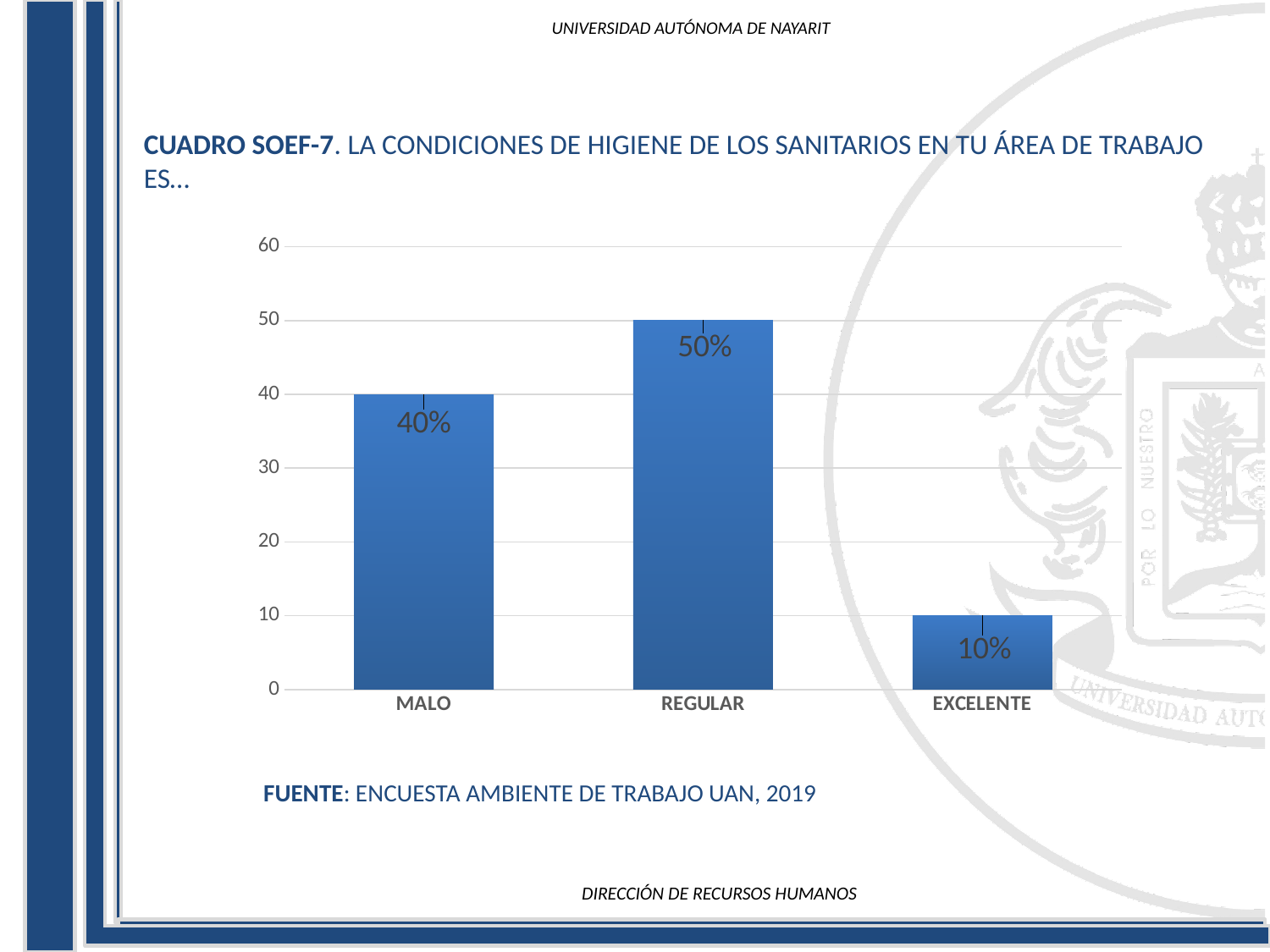
What is the value for EXCELENTE? 10% What is the difference between the values for REGULAR and MALO? 10% Is the value for REGULAR greater or less than 30? greater Which category has the highest value? REGULAR What source is cited below the chart? ENCUESTA AMBIENTE DE TRABAJO UAN, 2019 What is the difference between the values for MALO and EXCELENTE? 30% What is the value for MALO? 40% What kind of chart is shown on the slide? bar chart Which category has the lowest value? EXCELENTE How many categories are shown on the x axis? 3 Which is larger, the value for MALO or the value for EXCELENTE? MALO What is the value for REGULAR? 50%